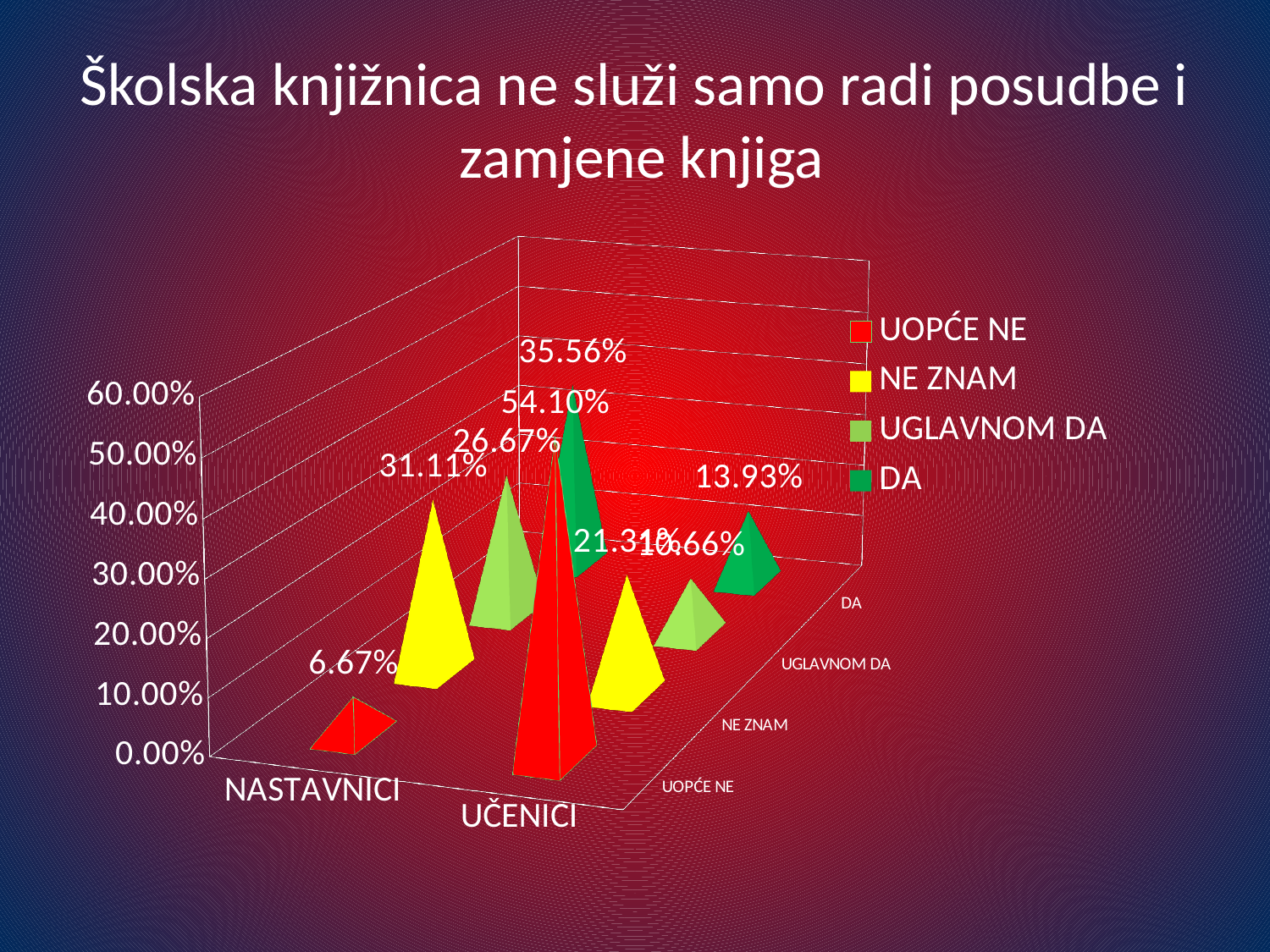
Which series has the lowest value for NASTAVNICI? UOPĆE NE How many series does the legend list? 4 What is the value for UČENICI in the DA series? 13.93% What is the value for UČENICI in the UOPĆE NE series? 54.10% What is the value for NASTAVNICI in the DA series? 35.56% What is the title of the chart? Školska knjižnica ne služi samo radi posudbe i zamjene knjiga What is the difference between the UOPĆE NE values for UČENICI and NASTAVNICI? 47.43% Which series has the highest value for UČENICI? UOPĆE NE What is the value for NASTAVNICI in the NE ZNAM series? 31.11% What is the value for NASTAVNICI in the UOPĆE NE series? 6.67% Which is larger: the DA value for NASTAVNICI or the DA value for UČENICI? NASTAVNICI How many categories are shown on the x axis? 2